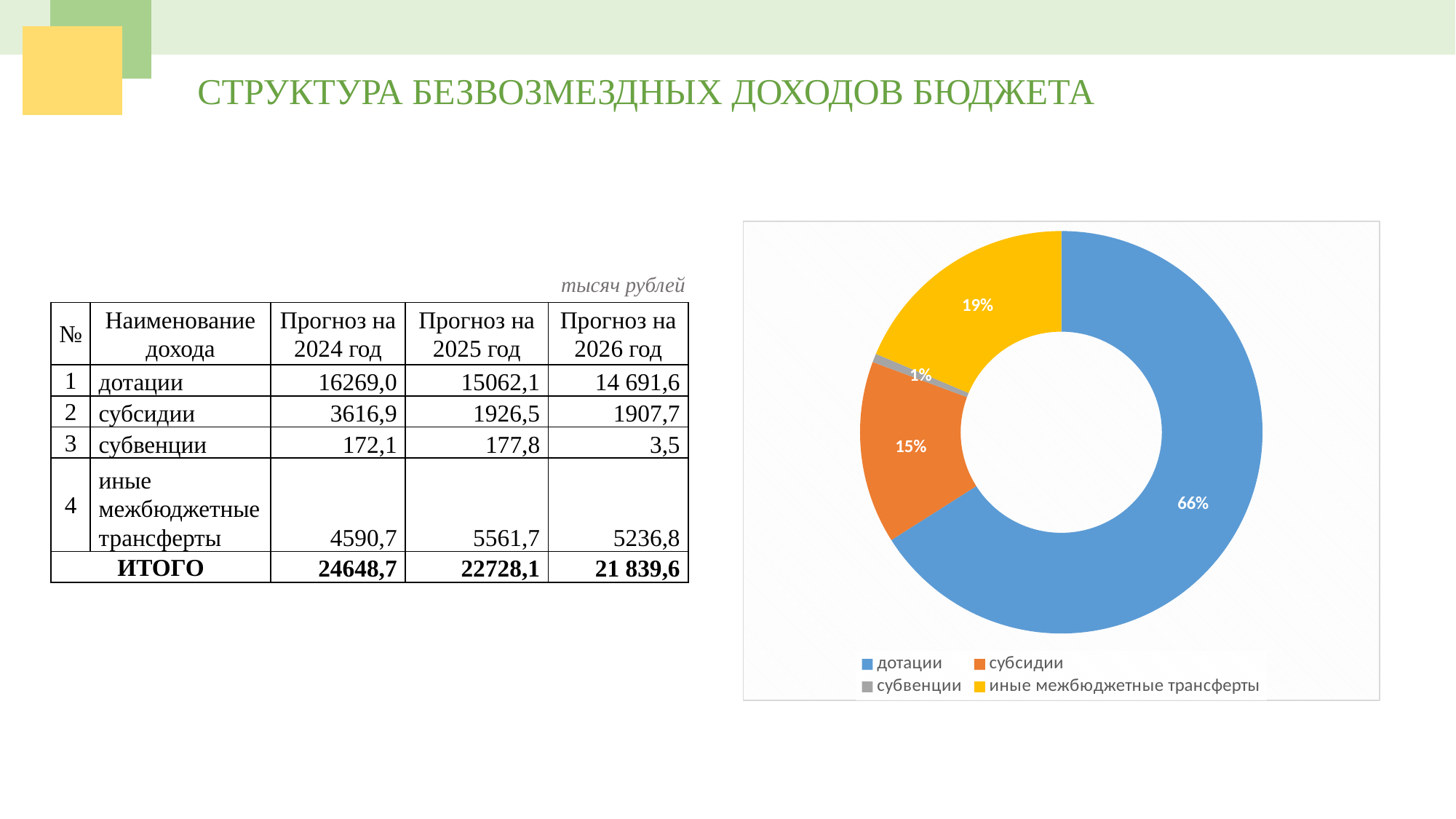
What is the difference in percentage points between the дотации slice and the иные межбюджетные трансферты slice? 47% Which slice is larger in the doughnut chart: субсидии or иные межбюджетные трансферты? иные межбюджетные трансферты How many entries does the chart legend list? 4 What share of the doughnut chart does субсидии take? 15% What share of the doughnut chart does иные межбюджетные трансферты take? 19% What share of the doughnut chart does дотации take? 66% How many slices does the doughnut chart have? 4 Which category has the largest slice in the doughnut chart? дотации What kind of chart is shown on the slide? Doughnut chart Which category has the smallest slice in the doughnut chart? субвенции What colour is the дотации slice in the doughnut chart? Blue